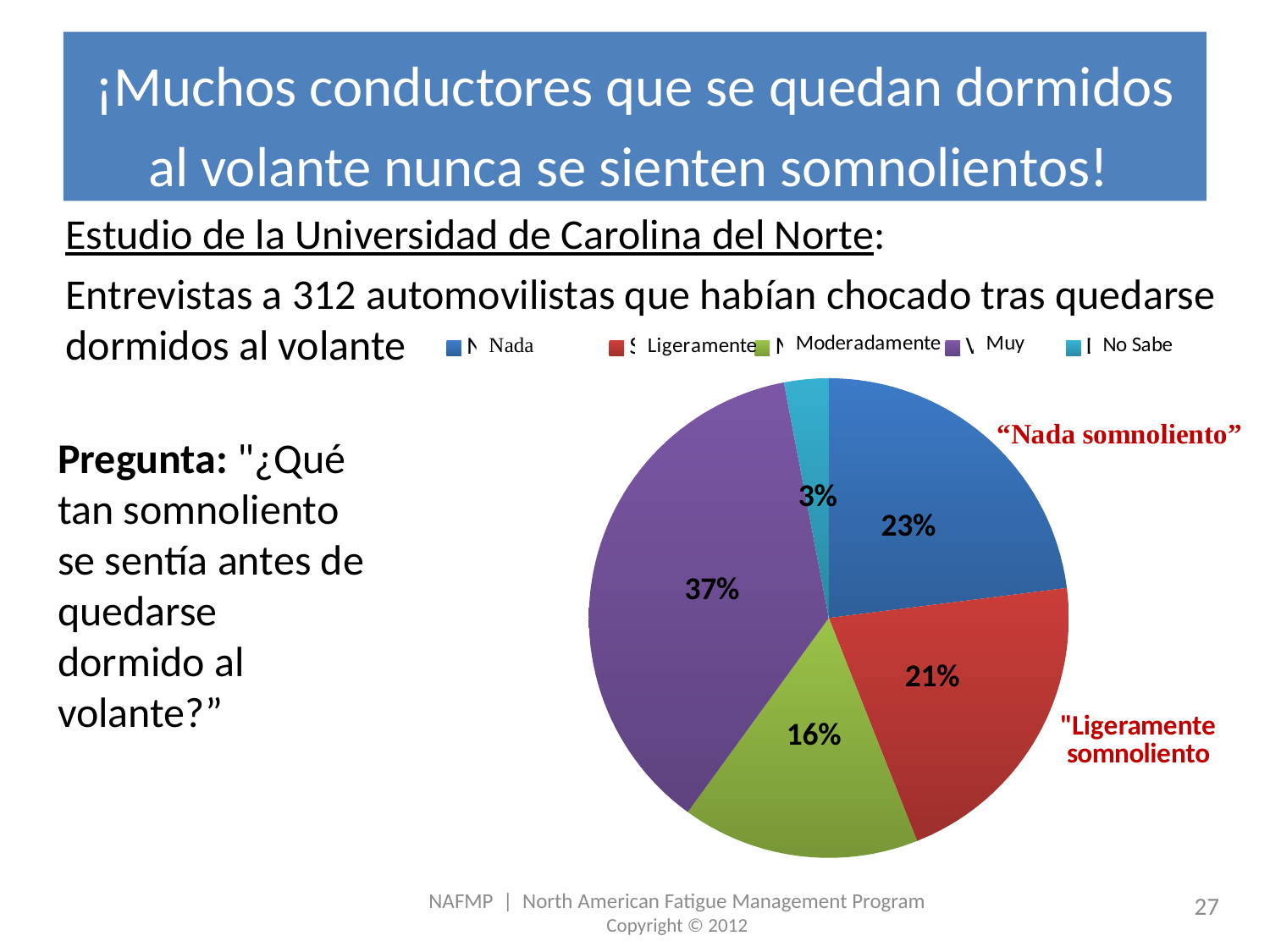
How many slices does the pie chart have? 5 What percentage of the pie chart is labelled "Moderadamente"? 16% What is the difference in percentage points between the "Muy" slice and the "Nada" slice? 14 What percentage of the pie chart is labelled "Ligeramente"? 21% Which category has the smallest slice of the pie chart? No Sabe Which category has the largest slice of the pie chart? Muy What percentage of the pie chart is labelled "Nada"? 23% What percentage of the pie chart is labelled "Muy"? 37% Which slice is larger, "Nada" or "Moderadamente"? Nada What percentage of the pie chart is labelled "No Sabe"? 3% What colour is the "Muy" slice in the pie chart? Purple What type of chart is shown on the slide? Pie chart